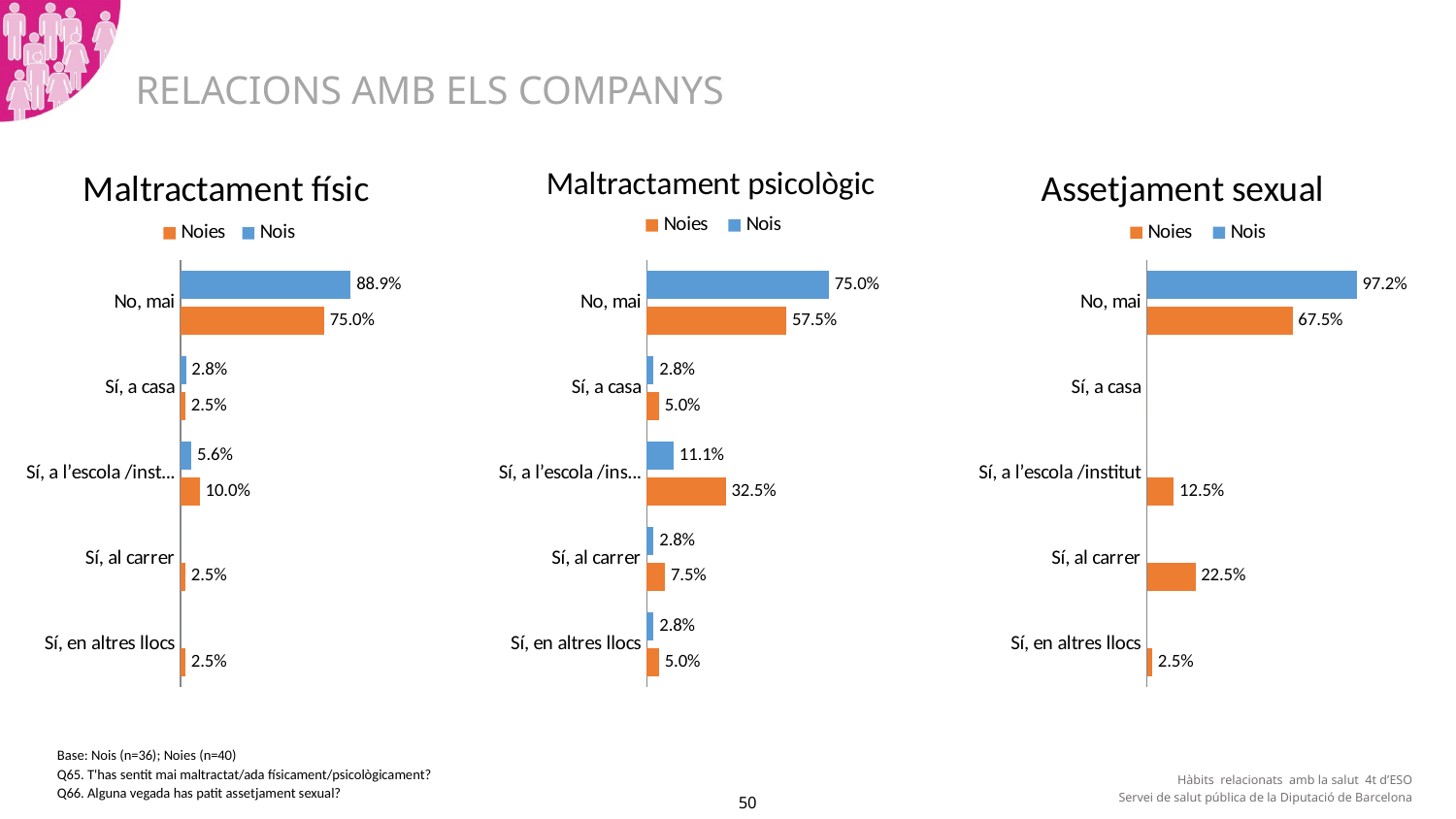
How many categories are shown in the 'Assetjament sexual' chart? 5 In the 'Maltractament físic' chart, what is the value for Noies in the 'Sí, a l'escola /institut' category? 10.0% In the 'Maltractament físic' chart, what is the difference between Nois and Noies in the 'No, mai' category? 13.9% In the 'Maltractament psicològic' chart, what is the difference between Nois and Noies in the 'No, mai' category? 17.5% In the 'Assetjament sexual' chart, what is the value for Noies in the 'Sí, al carrer' category? 22.5% In the 'Maltractament físic' chart, what is the value for Nois in the 'No, mai' category? 88.9% In the 'Assetjament sexual' chart, what is the value for Nois in the 'No, mai' category? 97.2% What kind of chart is the 'Maltractament psicològic' chart? Bar chart In the 'Maltractament psicològic' chart, what is the value for Noies in the 'Sí, a l'escola /institut' category? 32.5% How many series does the legend of the 'Maltractament físic' chart list? 2 In the 'Assetjament sexual' chart, which category has the highest value for Noies? No, mai In the 'Maltractament psicològic' chart, which is larger in the 'Sí, al carrer' category, Noies or Nois? Noies